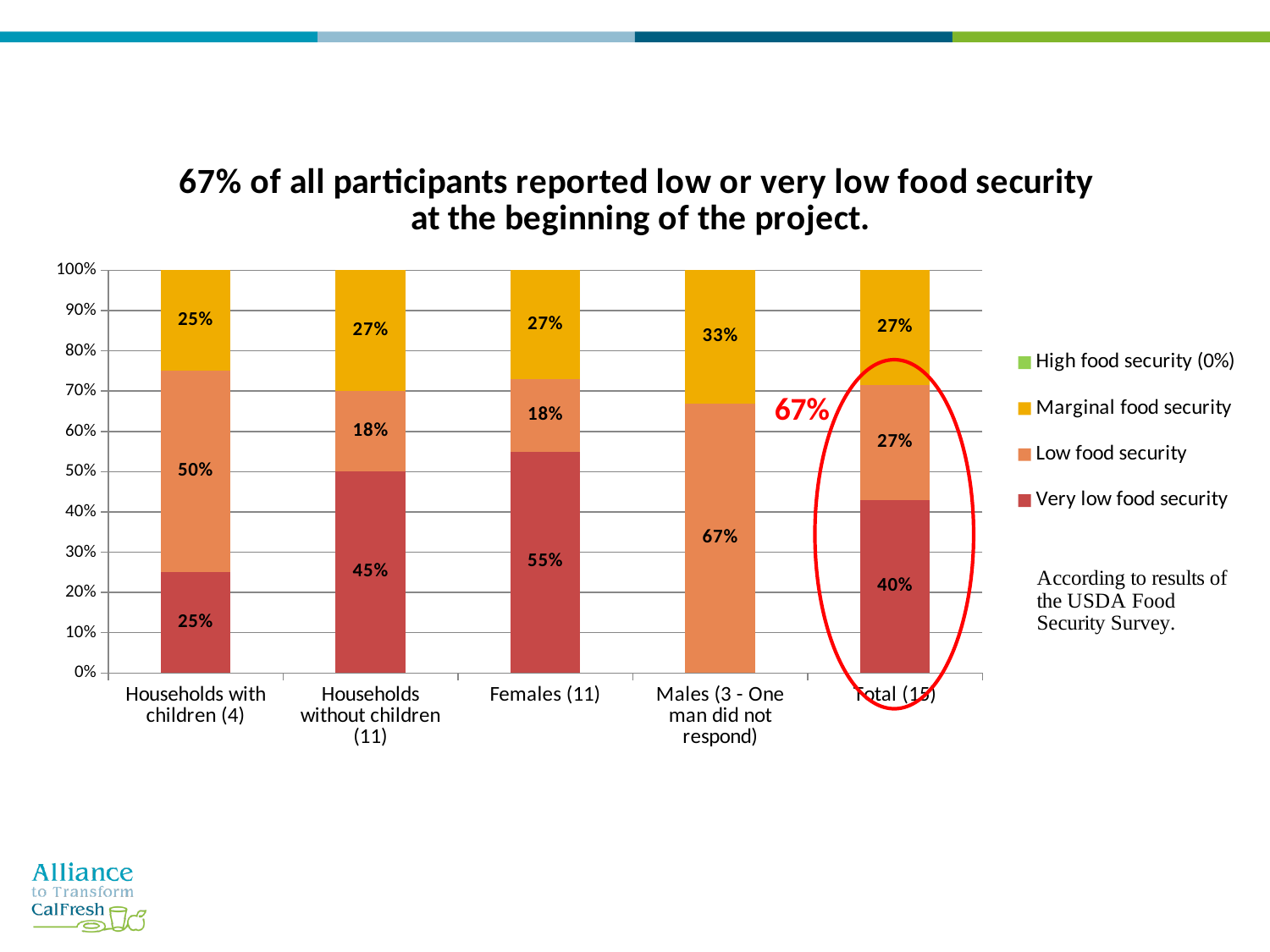
How many categories are shown along the x axis? 5 How many series does the legend list? 4 What is the Very low food security value for Households with children (4)? 25% What is the difference between the Very low food security values for Females (11) and Households without children (11)? 10% What is the title of the chart? 67% of all participants reported low or very low food security at the beginning of the project. Which category has the highest Very low food security value? Females (11) What is the Marginal food security value for Females (11)? 27% Which is larger: the Low food security value for Households with children (4) or for Total (15)? Households with children (4) What is the Very low food security value for Total (15)? 40% Which category has the highest Marginal food security value? Males (3 - One man did not respond) What type of chart is shown on the slide? Stacked bar chart What is the Low food security value for Males (3 - One man did not respond)? 67%